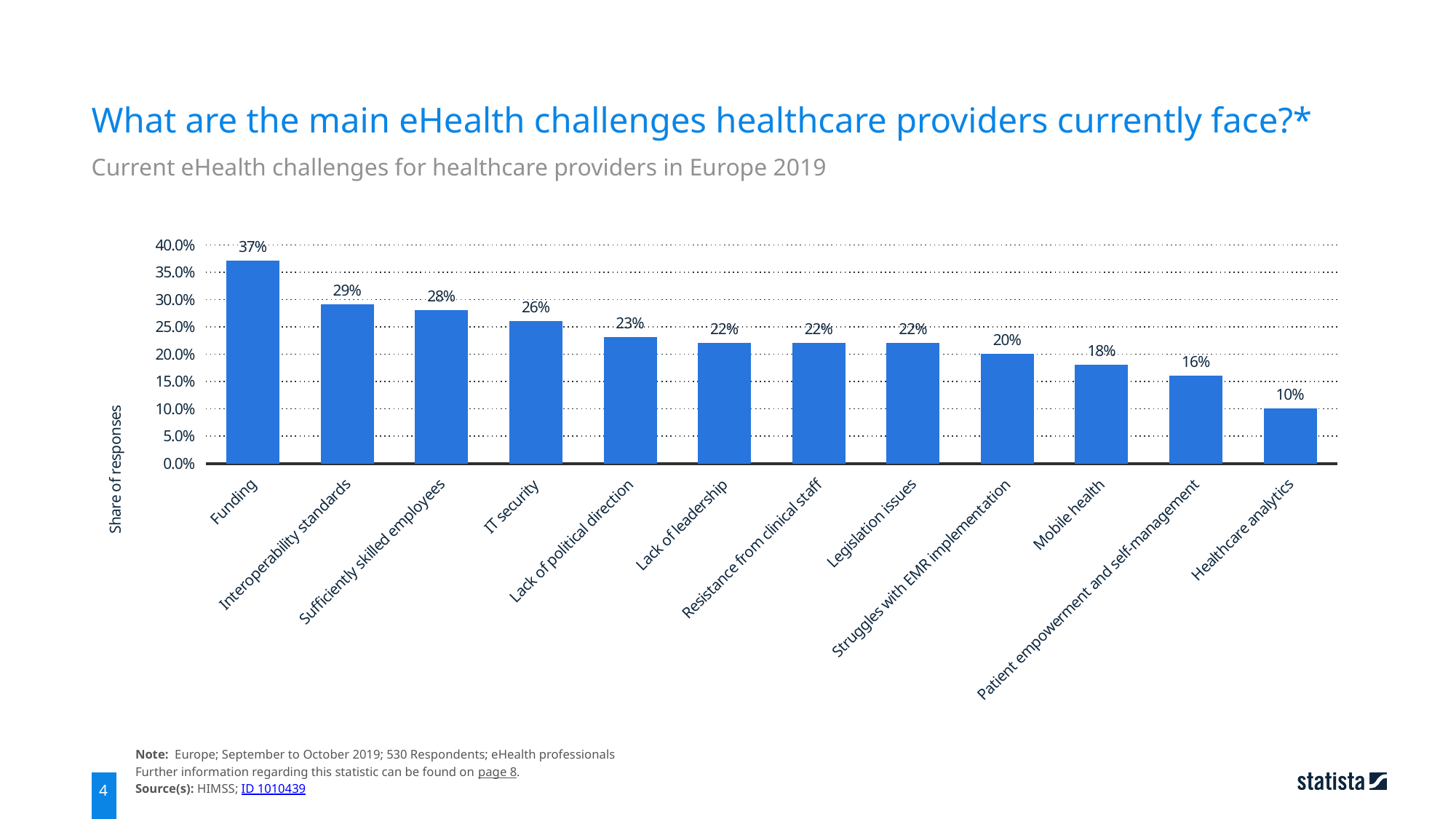
Which has a larger share of responses, Sufficiently skilled employees or Lack of political direction? Sufficiently skilled employees Is the value for Patient empowerment and self-management greater or less than 20.0%? less What share of responses is shown for Funding? 37% What is the difference in share of responses between Struggles with EMR implementation and Healthcare analytics? 10% What is the difference in share of responses between Funding and Interoperability standards? 8% Which challenge has the lowest share of responses? Healthcare analytics What share of responses is shown for IT security? 26% What kind of chart is shown on the slide? Bar chart What is the label of the vertical axis? Share of responses Which challenge has the highest share of responses? Funding How many challenges are shown in the chart? 12 What share of responses is shown for Mobile health? 18%